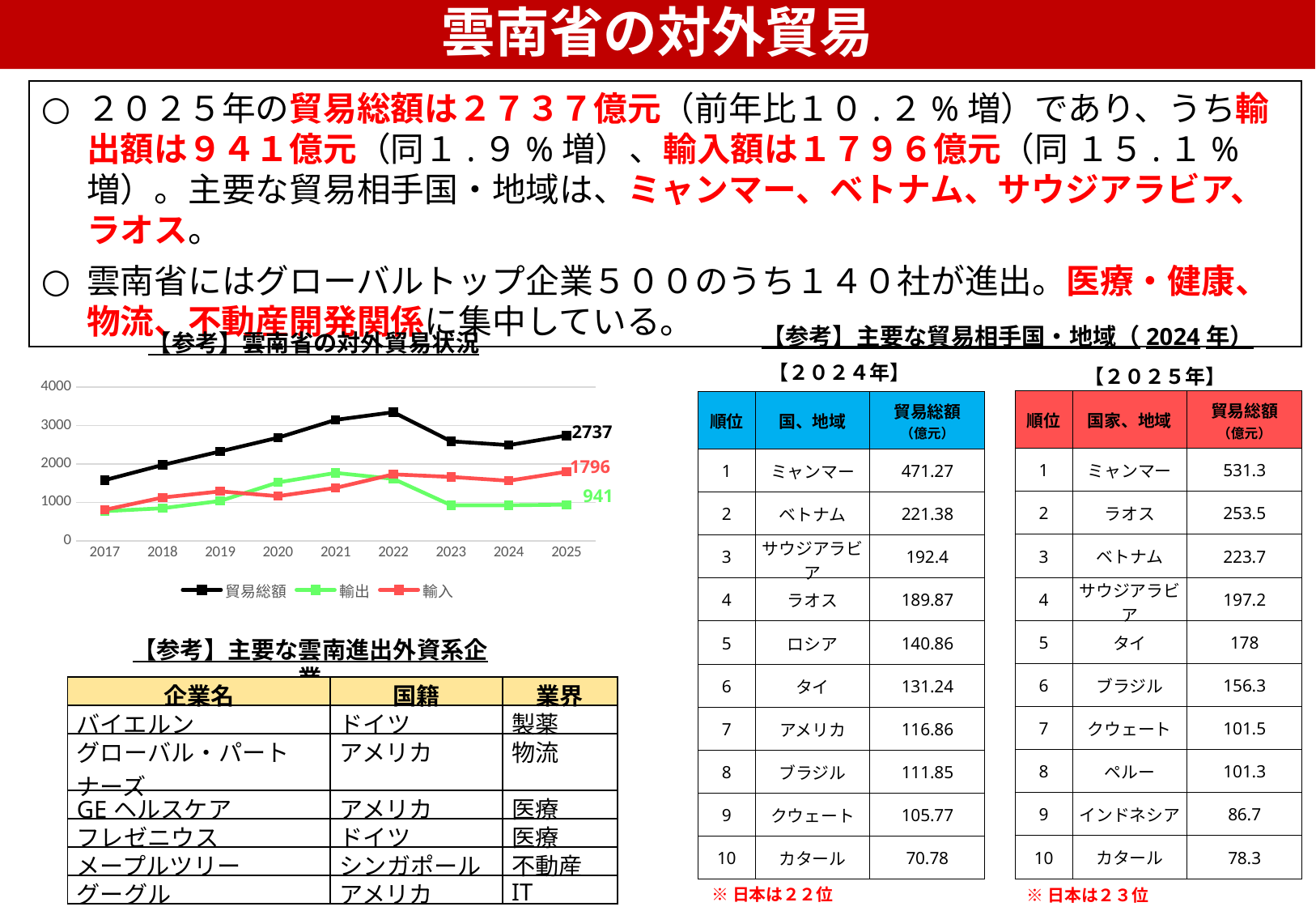
What kind of chart is 【参考】雲南省の対外貿易状況? line chart In the 雲南省の対外貿易状況 chart, is the 貿易総額 value for 2017 greater or less than 2000? less In the 雲南省の対外貿易状況 chart, what is the difference between 輸入 and 輸出 in 2025? 855 How many years are plotted on the x axis of the 雲南省の対外貿易状況 chart? 9 In the 雲南省の対外貿易状況 chart, what is the value of 輸出 for 2025? 941 How many series does the legend of the 雲南省の対外貿易状況 chart list? 3 In the 雲南省の対外貿易状況 chart, which year has the highest 貿易総額? 2022 In the 雲南省の対外貿易状況 chart, is the 貿易総額 value for 2022 greater or less than 3000? greater In the 雲南省の対外貿易状況 chart, does 貿易総額 rise or fall from 2017 to 2022? rise In the 雲南省の対外貿易状況 chart, what is the value of 輸入 for 2025? 1796 In the 雲南省の対外貿易状況 chart, what is the value of 貿易総額 for 2025? 2737 In the 雲南省の対外貿易状況 chart, which is larger in 2025, 輸入 or 輸出? 輸入